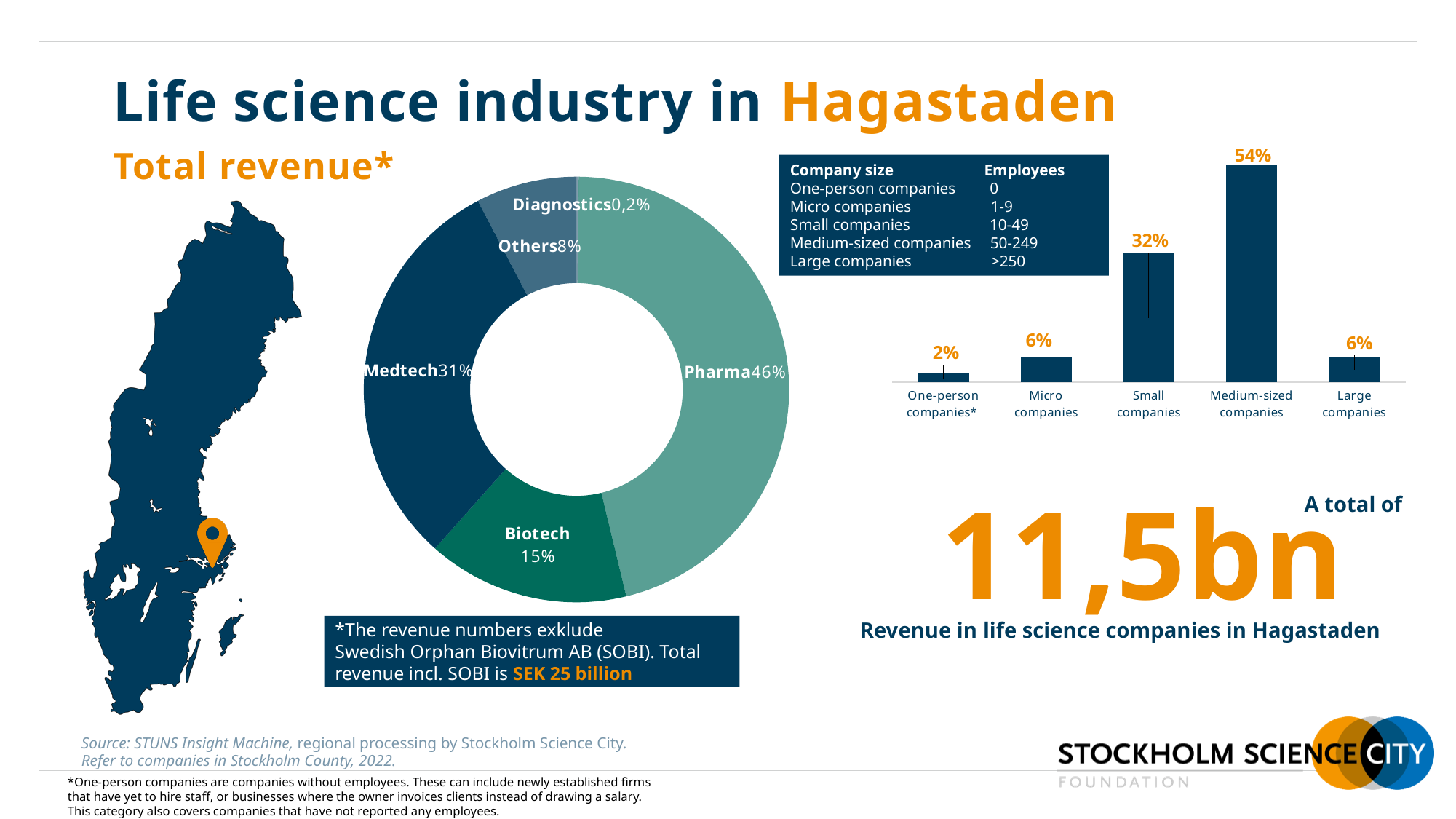
In the bar chart by company size, what is the value for Medium-sized companies? 54% In the Total revenue donut chart, which category has the largest share? Pharma What type of chart is the chart by company size on the right of the slide? Bar chart In the Total revenue donut chart, what share does Medtech have? 31% In the Total revenue donut chart, how many categories are shown? 5 In the Total revenue donut chart, what share does Biotech have? 15% In the Total revenue donut chart, what is the difference in percentage points between Pharma and Medtech? 15 In the bar chart by company size, which is larger: Micro companies or Small companies? Small companies In the Total revenue donut chart, what share does Pharma have? 46% In the Total revenue donut chart, which category has the smallest share? Diagnostics In the bar chart by company size, what is the value for Small companies? 32% In the bar chart by company size, which category has the lowest value? One-person companies*